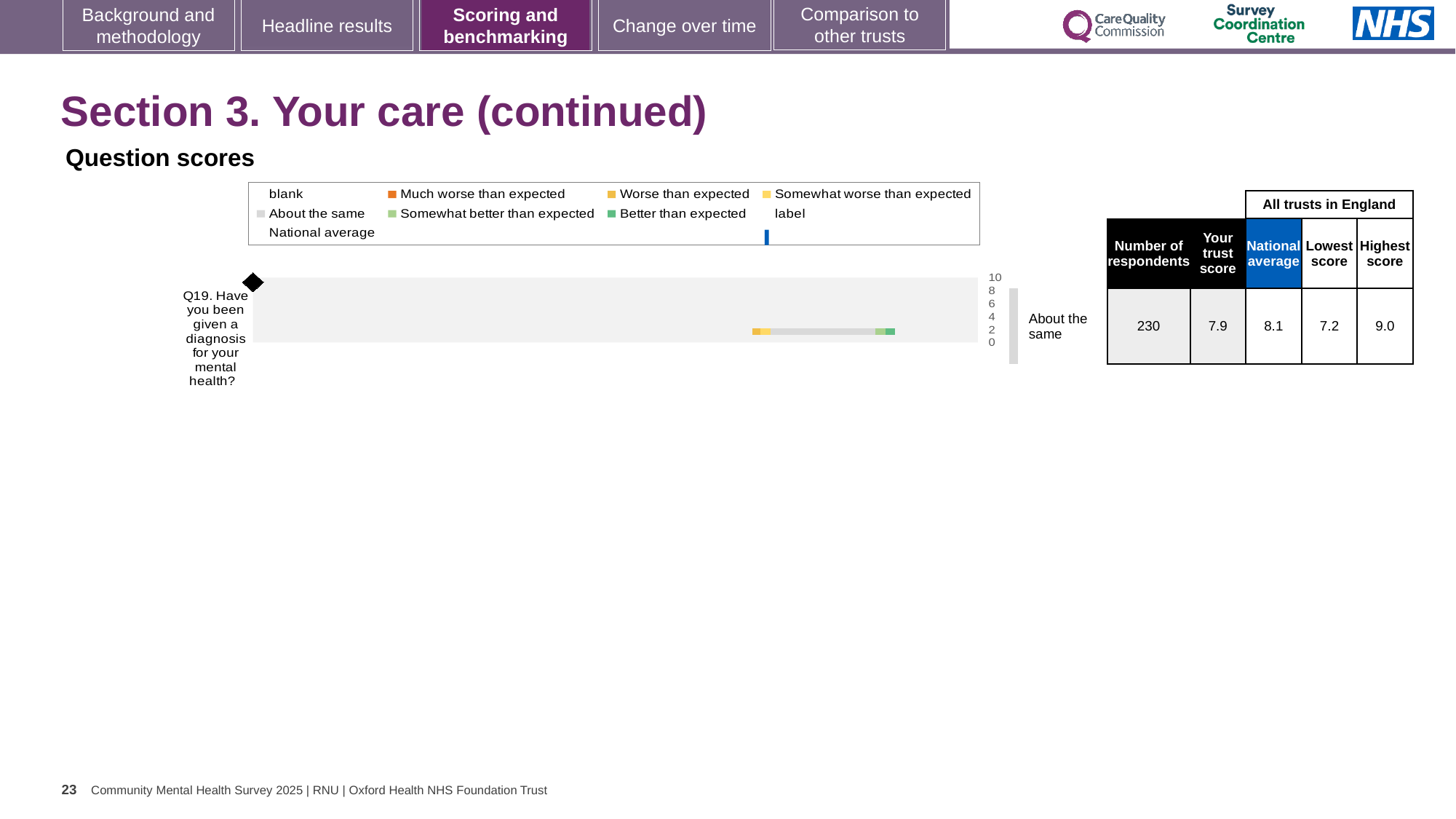
Is the trust score for Q19 greater or less than 8? less How many respondents answered Q19? 230 What is the highest score among all trusts in England for Q19? 9.0 What kind of chart is shown under 'Question scores'? bar chart What is the maximum value shown on the chart's score axis? 10 What is the difference between the highest and lowest trust scores for Q19? 1.8 Which is larger for Q19: the trust score or the national average? National average What benchmark category is shown for Q19? About the same How many questions are plotted in the Question scores chart? 1 What is the national average score for Q19? 8.1 What is the 'Your trust score' for Q19 (Have you been given a diagnosis for your mental health?)? 7.9 What is the lowest score among all trusts in England for Q19? 7.2